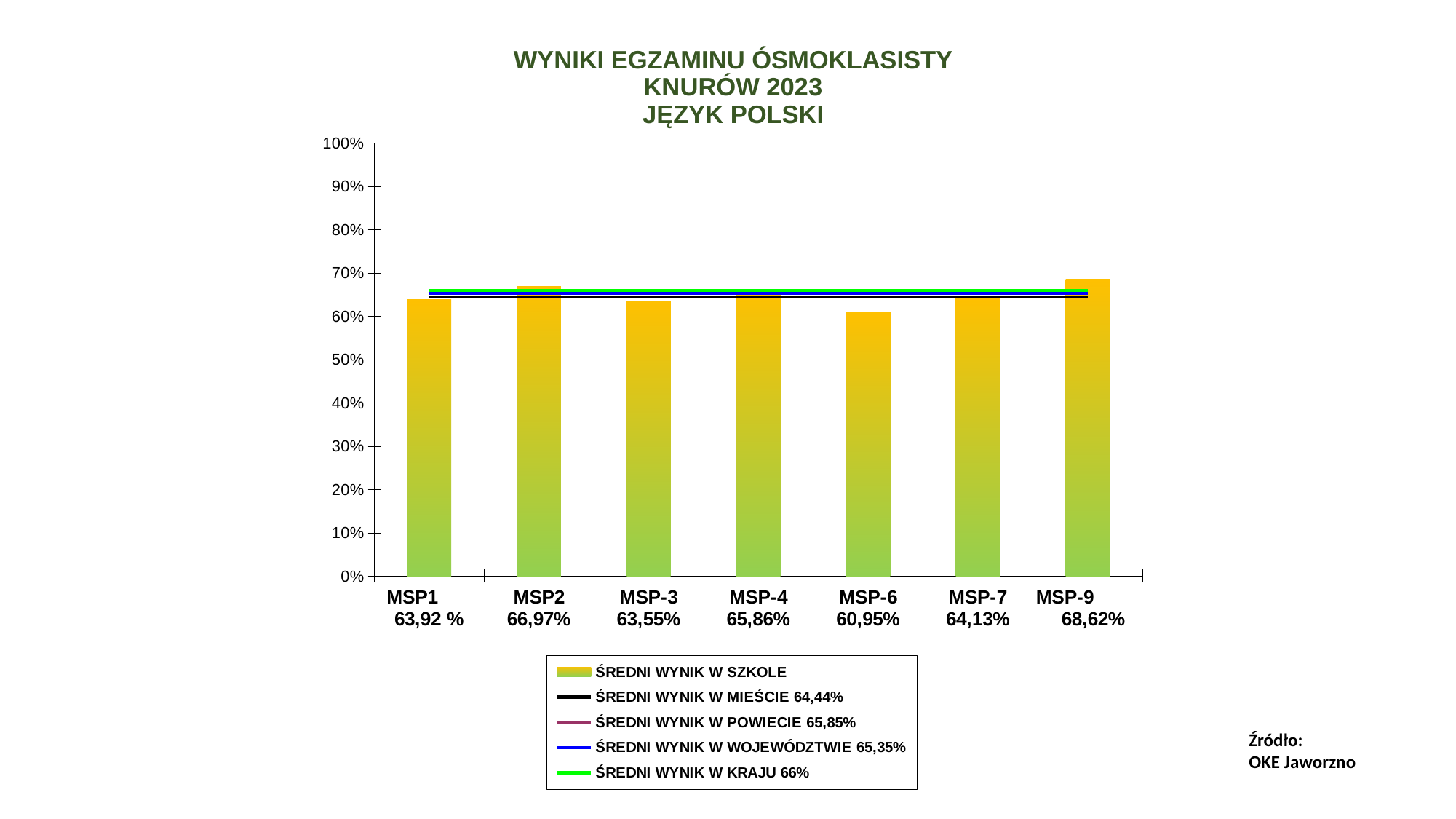
What is the average school result for MSP-6? 60,95% How many series does the legend list? 5 Which school has a higher result, MSP-4 or MSP-7? MSP-4 How many schools are shown on the x axis? 7 Which school has the lowest average result? MSP-6 What is the average result in the country (ŚREDNI WYNIK W KRAJU) shown in the legend? 66% Is the value for MSP-3 greater or less than 70%? less What is the average school result for MSP2? 66,97% What kind of chart is shown on the slide? combination bar and line chart Which school has the highest average result? MSP-9 What is the difference between the results of MSP-9 and MSP-6? 7,67 percentage points What is the average school result for MSP-9? 68,62%